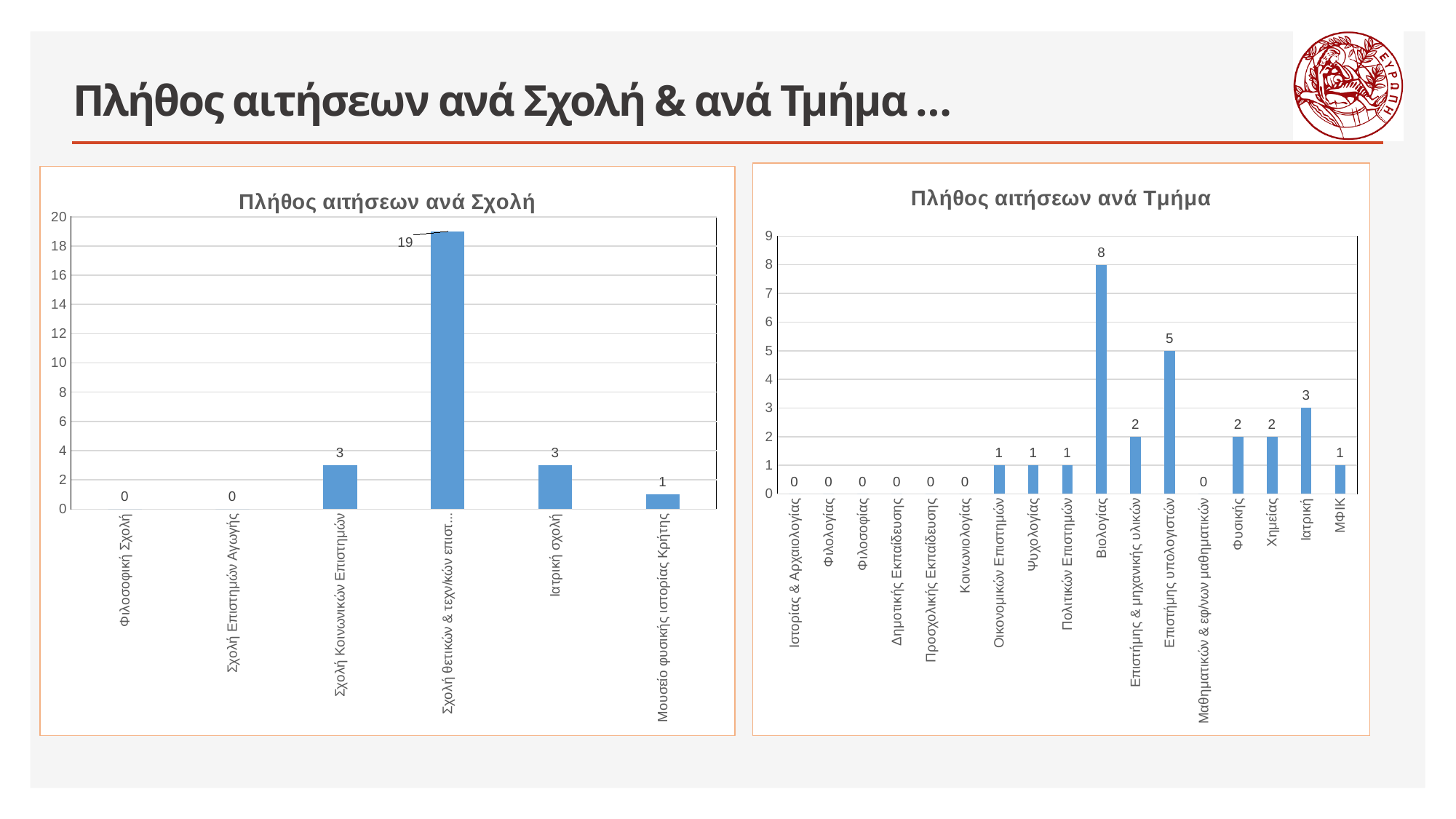
In the chart 'Πλήθος αιτήσεων ανά Τμήμα', what is the difference between the value for Βιολογίας and the value for Επιστήμης υπολογιστών? 3 In the chart 'Πλήθος αιτήσεων ανά Τμήμα', which category has the highest value? Βιολογίας In the chart 'Πλήθος αιτήσεων ανά Σχολή', what is the value for Μουσείο φυσικής ιστορίας Κρήτης? 1 In the chart 'Πλήθος αιτήσεων ανά Τμήμα', what is the value for Επιστήμης υπολογιστών? 5 In the chart 'Πλήθος αιτήσεων ανά Τμήμα', what is the value for Βιολογίας? 8 In the chart 'Πλήθος αιτήσεων ανά Σχολή', which category has the highest value? Σχολή θετικών & τεχν/κών επιστ... In the chart 'Πλήθος αιτήσεων ανά Σχολή', what is the value for Σχολή Κοινωνικών Επιστημών? 3 In the chart 'Πλήθος αιτήσεων ανά Σχολή', how many categories are shown on the x axis? 6 What kind of chart is 'Πλήθος αιτήσεων ανά Τμήμα'? Bar chart In the chart 'Πλήθος αιτήσεων ανά Σχολή', what is the difference between the value for Σχολή θετικών & τεχνικών επιστ... and the value for Ιατρική σχολή? 16 In the chart 'Πλήθος αιτήσεων ανά Τμήμα', how many categories are shown on the x axis? 17 In the chart 'Πλήθος αιτήσεων ανά Τμήμα', which is larger, the value for Ιατρική or the value for Φυσικής? Ιατρική